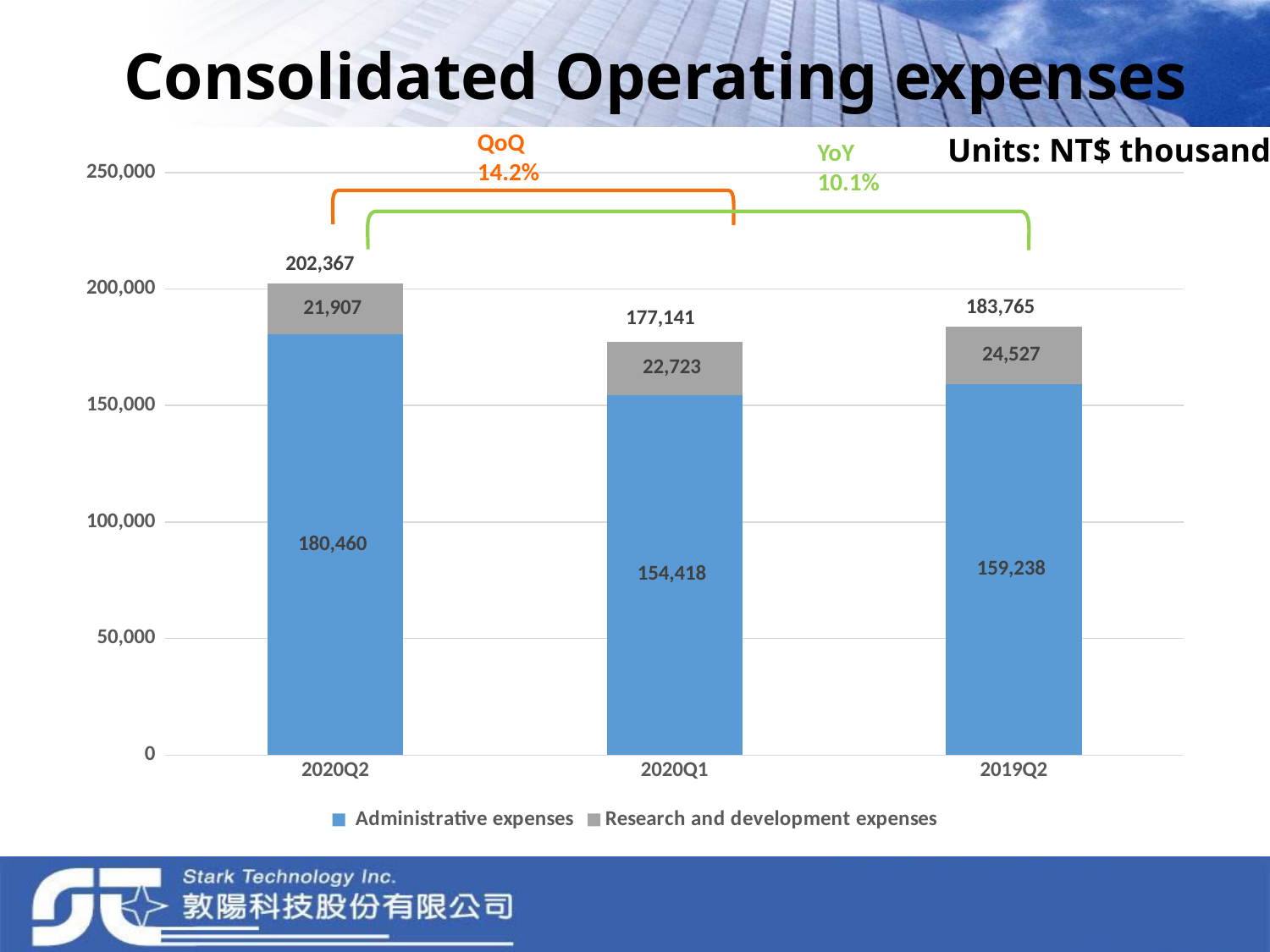
How many quarters are shown on the x axis? 3 Which quarter has the highest total operating expenses? 2020Q2 What is the value of Research and development expenses for 2019Q2? 24,527 What is the total of the stacked bar for 2020Q1? 177,141 What is the value of Administrative expenses for 2020Q2? 180,460 Which is larger, Research and development expenses in 2020Q1 or in 2019Q2? 2019Q2 Which quarter has the lowest Administrative expenses? 2020Q1 What kind of chart is shown on the slide? Stacked bar chart What is the value of Administrative expenses for 2020Q1? 154,418 What is the difference between Administrative expenses in 2020Q2 and 2020Q1? 26,042 What is the QoQ percentage change shown on the chart? 14.2% How many series does the legend list? 2